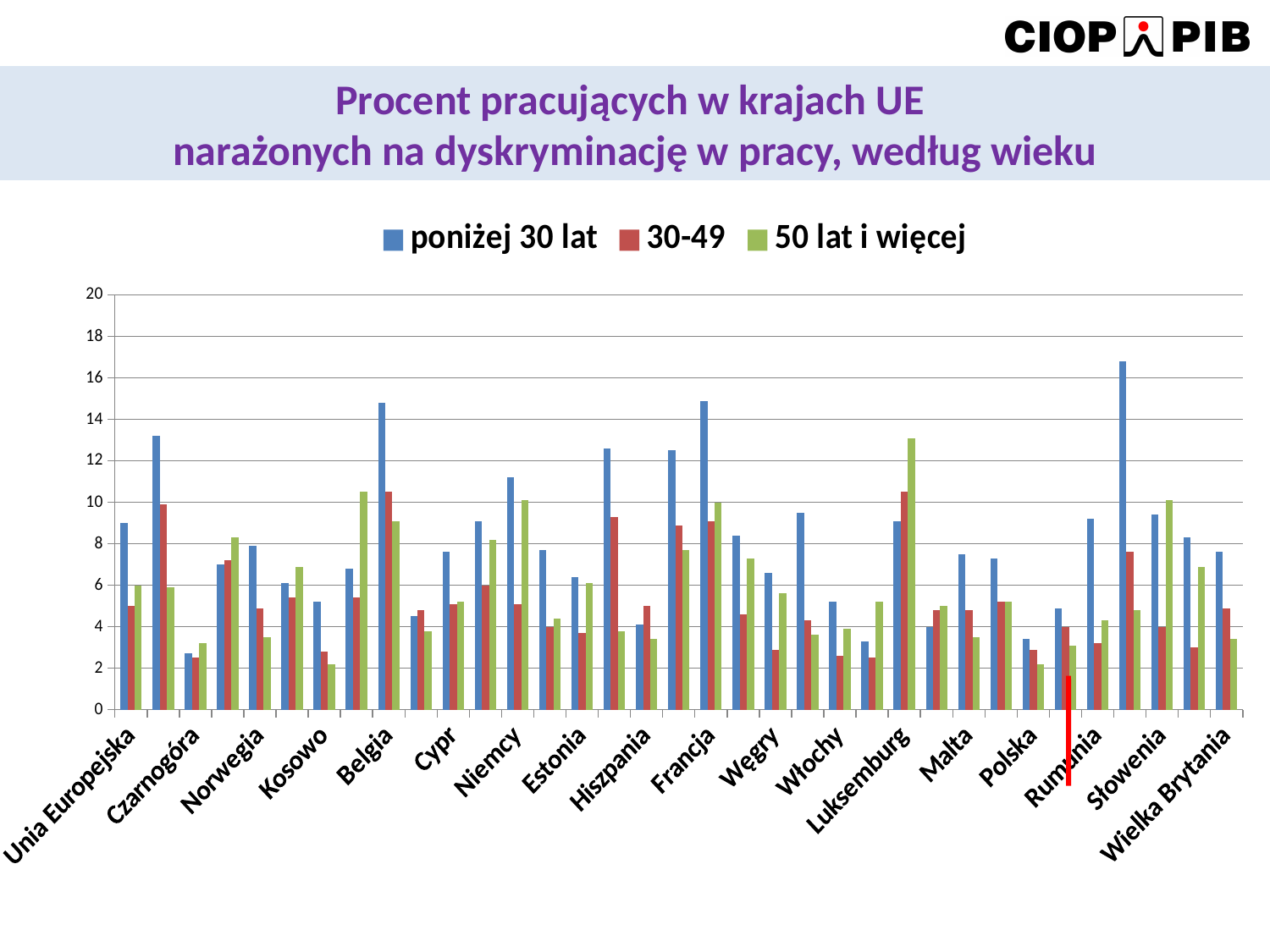
Is the value for '50 lat i więcej' in Luksemburg greater or less than 12? greater Is the value for 'poniżej 30 lat' in Francja greater or less than 12? greater Which colour represents the series '30-49'? red Is the value for 'poniżej 30 lat' in Belgia greater or less than 12? greater How many series does the legend list? 3 What kind of chart is shown on the slide? bar chart What are the three series named in the legend? poniżej 30 lat, 30-49, 50 lat i więcej In Luksemburg, which is larger: the value for '50 lat i więcej' or for 'poniżej 30 lat'? 50 lat i więcej In Belgia, which is larger: the value for 'poniżej 30 lat' or for '50 lat i więcej'? poniżej 30 lat